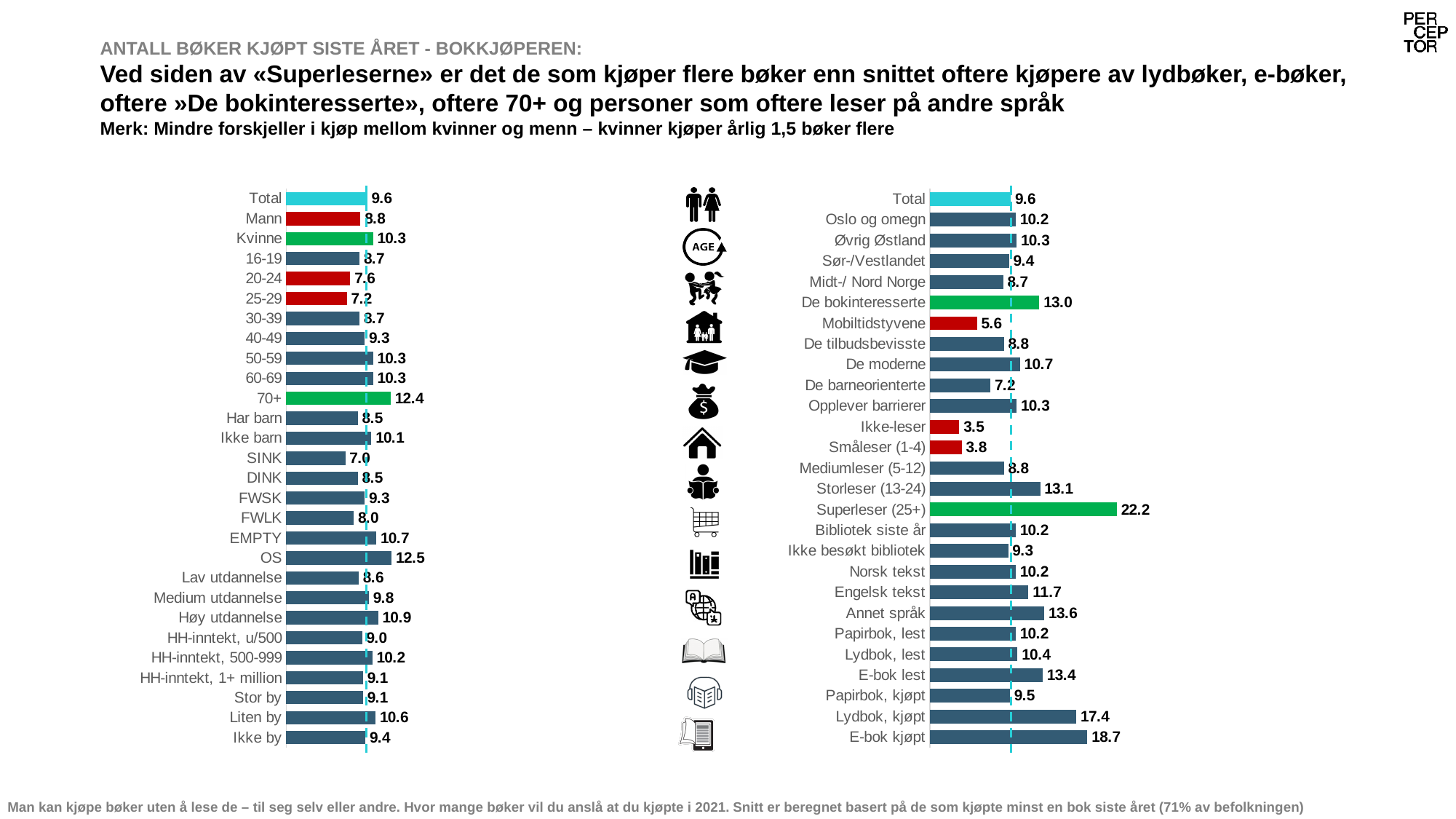
In the right chart, what is the difference between the values for E-bok kjøpt and Lydbok kjøpt? 1.3 In the right chart, what is the value for Superleser (25+)? 22.2 In the left chart, what is the value for 70+? 12.4 What type of chart is the left chart? Bar chart How many categories are shown in the right chart? 27 In the left chart, which category has the lowest value? SINK In the right chart, which category has the lowest value? Ikke-leser In the left chart, what is the difference between the values for Kvinne and Mann? 1.5 In the left chart, what is the value for Kvinne? 10.3 In the right chart, what is the value for Mobiltidstyvene? 5.6 In the left chart, which category has the highest value? OS In the left chart, which is larger, the value for Liten by or the value for Stor by? Liten by